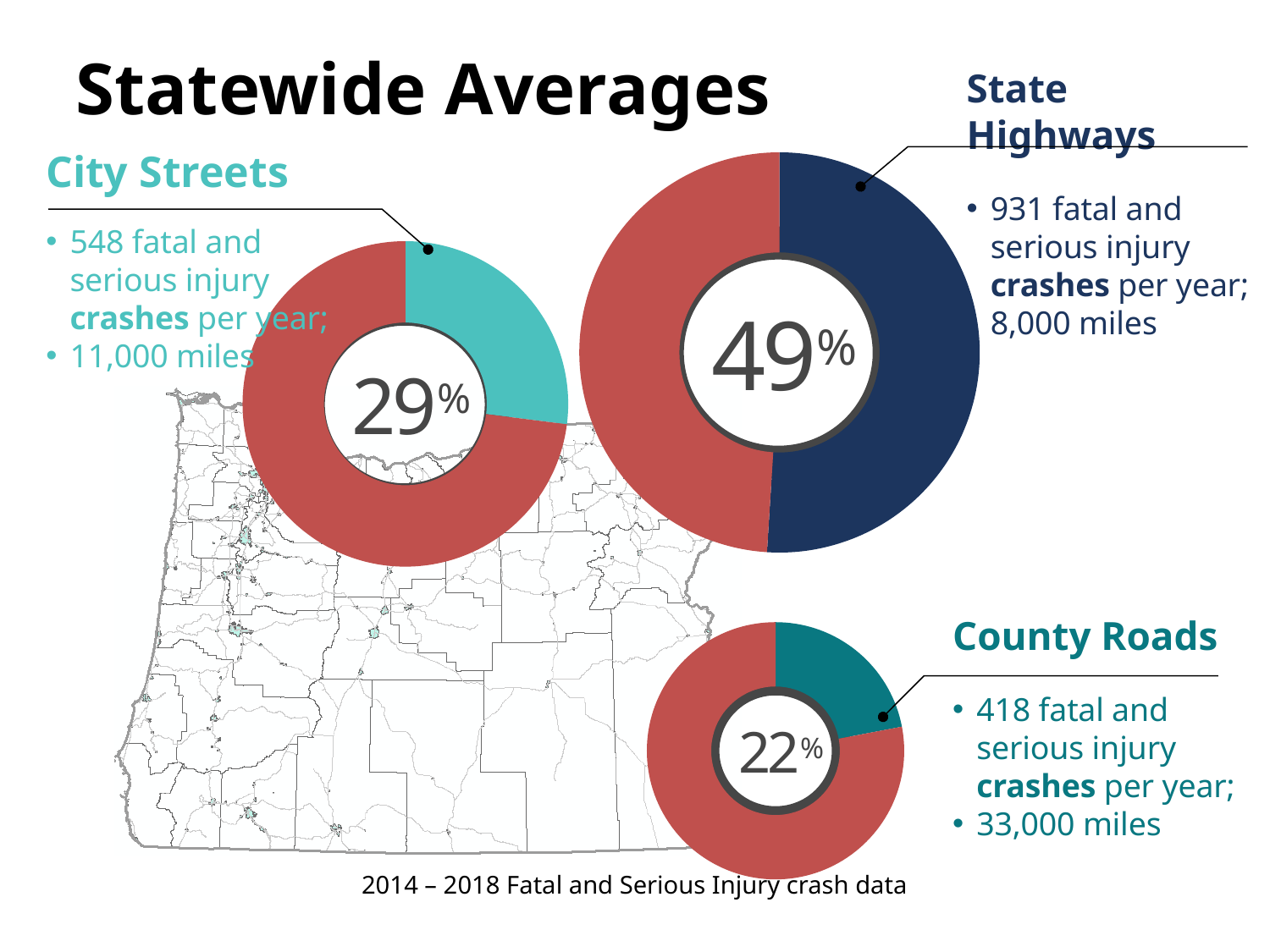
What is the difference between the State Highways percentage and the City Streets percentage? 20% What is the difference between the City Streets percentage and the County Roads percentage? 7% Which is larger, the City Streets percentage or the County Roads percentage? City Streets Which of the three donut charts shows the highest percentage? State Highways What percentage is shown in the centre of the City Streets donut chart? 29% What percentage is shown in the centre of the County Roads donut chart? 22% What percentage is shown in the centre of the State Highways donut chart? 49% What colour is the highlighted slice in the State Highways donut chart? Dark navy blue How many donut charts are shown on the slide? 3 According to the State Highways annotation, how many fatal and serious injury crashes occur per year? 931 What type of chart is used to show the percentages on this slide? Donut (pie) chart Which of the three donut charts shows the lowest percentage? County Roads